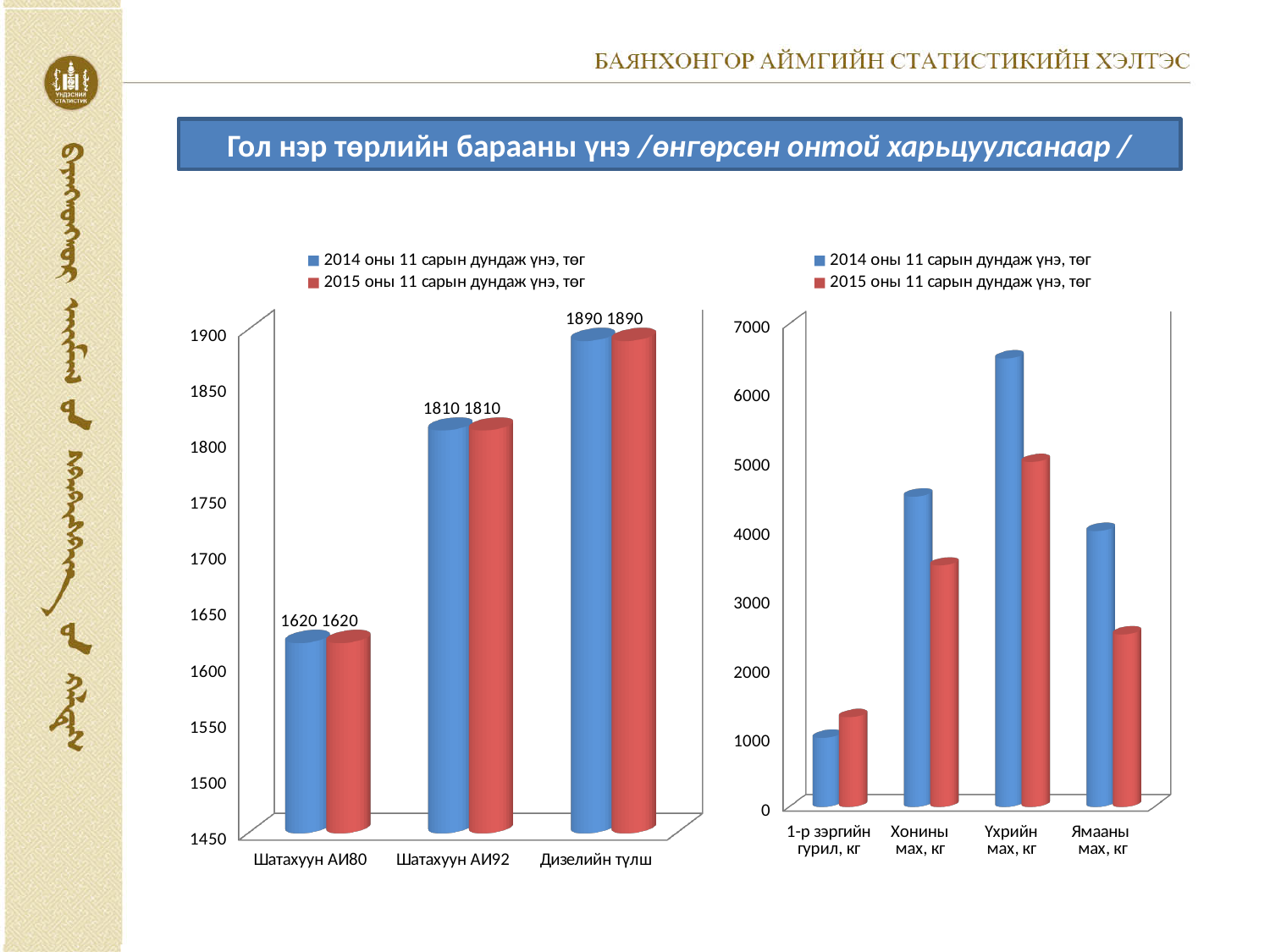
In the left chart, which category has the highest 2014 оны 11 сарын дундаж үнэ? Дизелийн түлш In the right chart, which is larger for Хонины мах, кг: the 2014 value or the 2015 value? 2014 value In the right chart, which category has the highest 2014 оны 11 сарын дундаж үнэ? Үхрийн мах, кг In the left chart, what is the difference between the 2014 values for Дизелийн түлш and Шатахуун АИ80? 270 In the right chart, is the 2014 оны 11 сарын дундаж үнэ for Үхрийн мах, кг greater or less than 6000? greater How many series does the legend of the right chart list? 2 In the left chart, what is the 2015 оны 11 сарын дундаж үнэ for Шатахуун АИ92? 1810 In the left chart, which category has the lowest 2015 оны 11 сарын дундаж үнэ? Шатахуун АИ80 What type of chart is the right chart? Bar chart In the left chart, what is the 2014 оны 11 сарын дундаж үнэ for Шатахуун АИ80? 1620 In the left chart, what is the 2015 оны 11 сарын дундаж үнэ for Дизелийн түлш? 1890 How many categories are shown in the left chart? 3